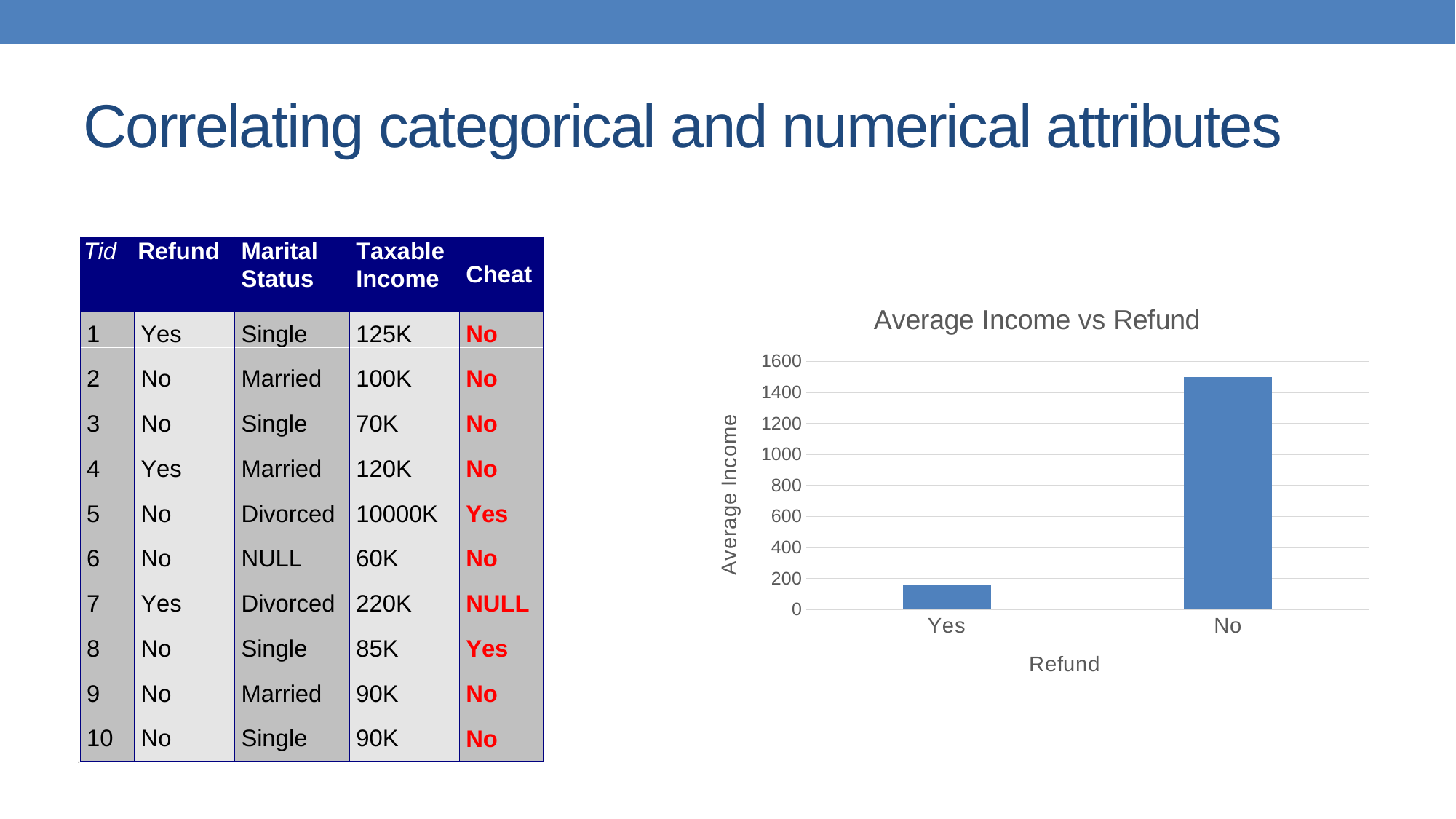
What kind of chart is shown on the slide? bar chart Is the average income for Refund = No greater or less than 1000? greater What is the label on the y axis of the chart? Average Income Which has a larger average income in the chart, Refund = Yes or Refund = No? No Which Refund category has the lowest average income in the chart? Yes Which Refund category has the highest average income in the chart? No How many categories are shown on the x axis of the chart? 2 Is the average income for Refund = Yes greater or less than 400? less What is the title of the chart? Average Income vs Refund Is the average income for Refund = Yes greater or less than 200? less